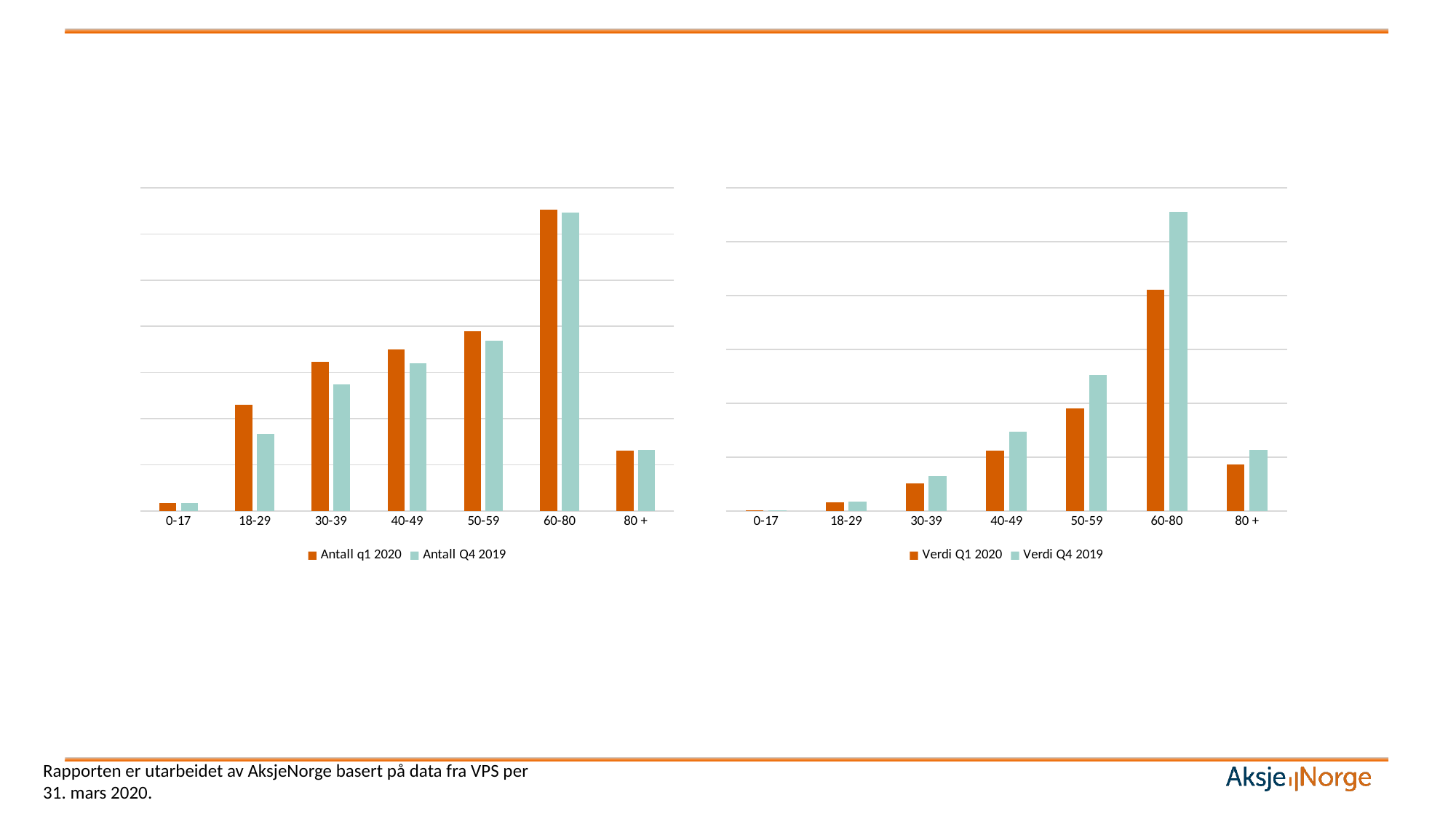
What are the two legend entries of the left chart? Antall q1 2020 and Antall Q4 2019 In the right chart, which colour represents Verdi Q1 2020? Orange In the left chart, for the 18-29 category, which is larger: Antall q1 2020 or Antall Q4 2019? Antall q1 2020 In the right chart, which age category has the lowest value for Verdi Q1 2020? 0-17 In the right chart, for the 60-80 category, which is larger: Verdi Q1 2020 or Verdi Q4 2019? Verdi Q4 2019 In the right chart, which age category has the highest value for Verdi Q4 2019? 60-80 What kind of chart is the left chart on the slide? Bar chart In the right chart, do the Verdi Q1 2020 values rise or fall from 0-17 to 60-80? Rise In the left chart, which age category has the highest value for Antall q1 2020? 60-80 How many age categories are shown on the x axis of the left chart? 7 How many series does the legend of the right chart list? 2 In the left chart, which age category has the lowest value for Antall Q4 2019? 0-17